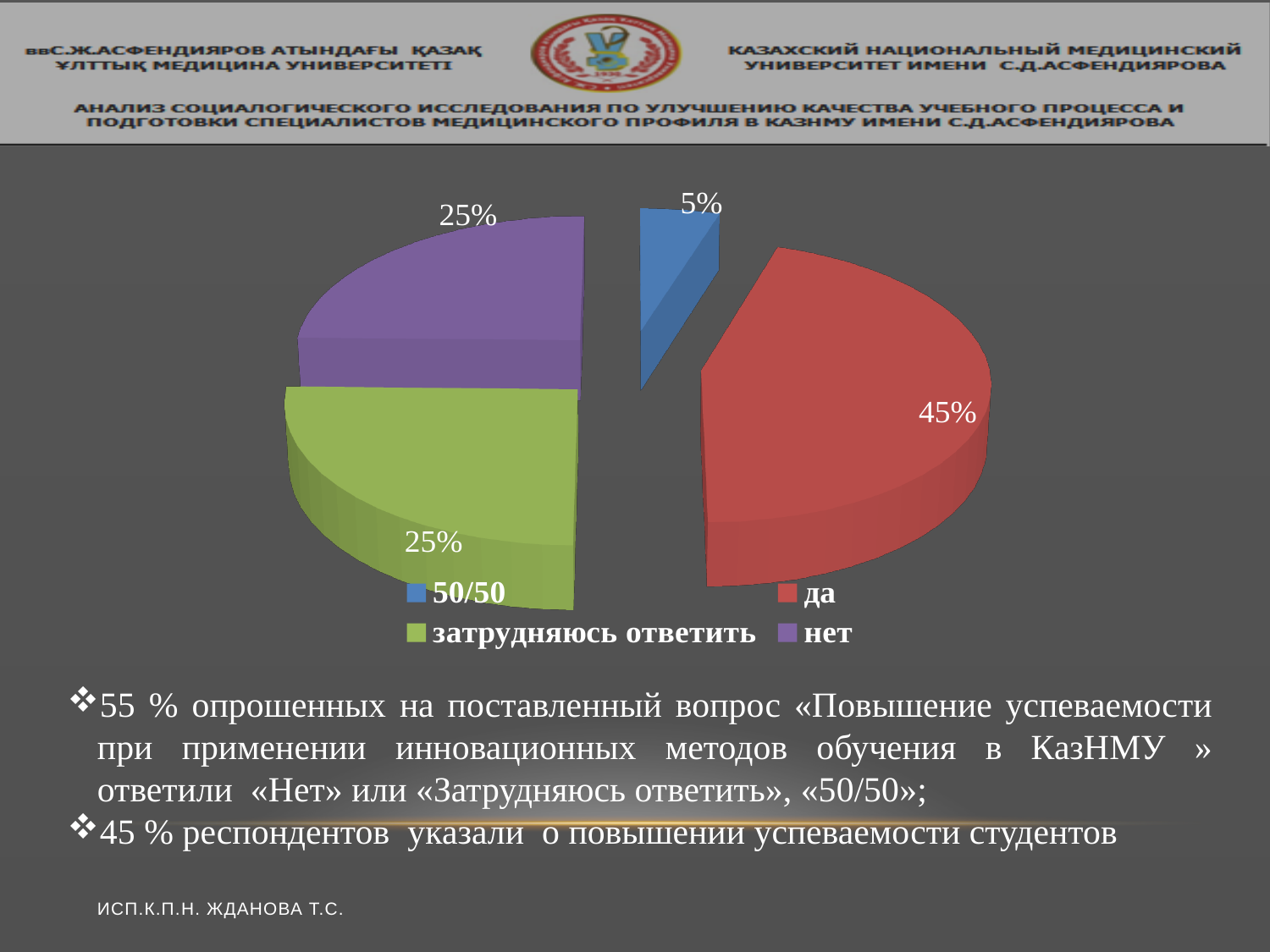
What percentage of respondents answered «нет»? 25% How many entries does the legend list? 4 How many slices does the pie chart have? 4 What percentage of respondents answered «да»? 45% What colour is the slice for «да»? red What percentage of respondents answered «50/50»? 5% What is the difference between the share for «да» and the share for «нет»? 20% Which answer has the smallest share of the pie? 50/50 What kind of chart is shown on the slide? pie chart Which is larger, the share for «да» or the share for «50/50»? да Which answer has the largest share of the pie? да What percentage of respondents answered «затрудняюсь ответить»? 25%